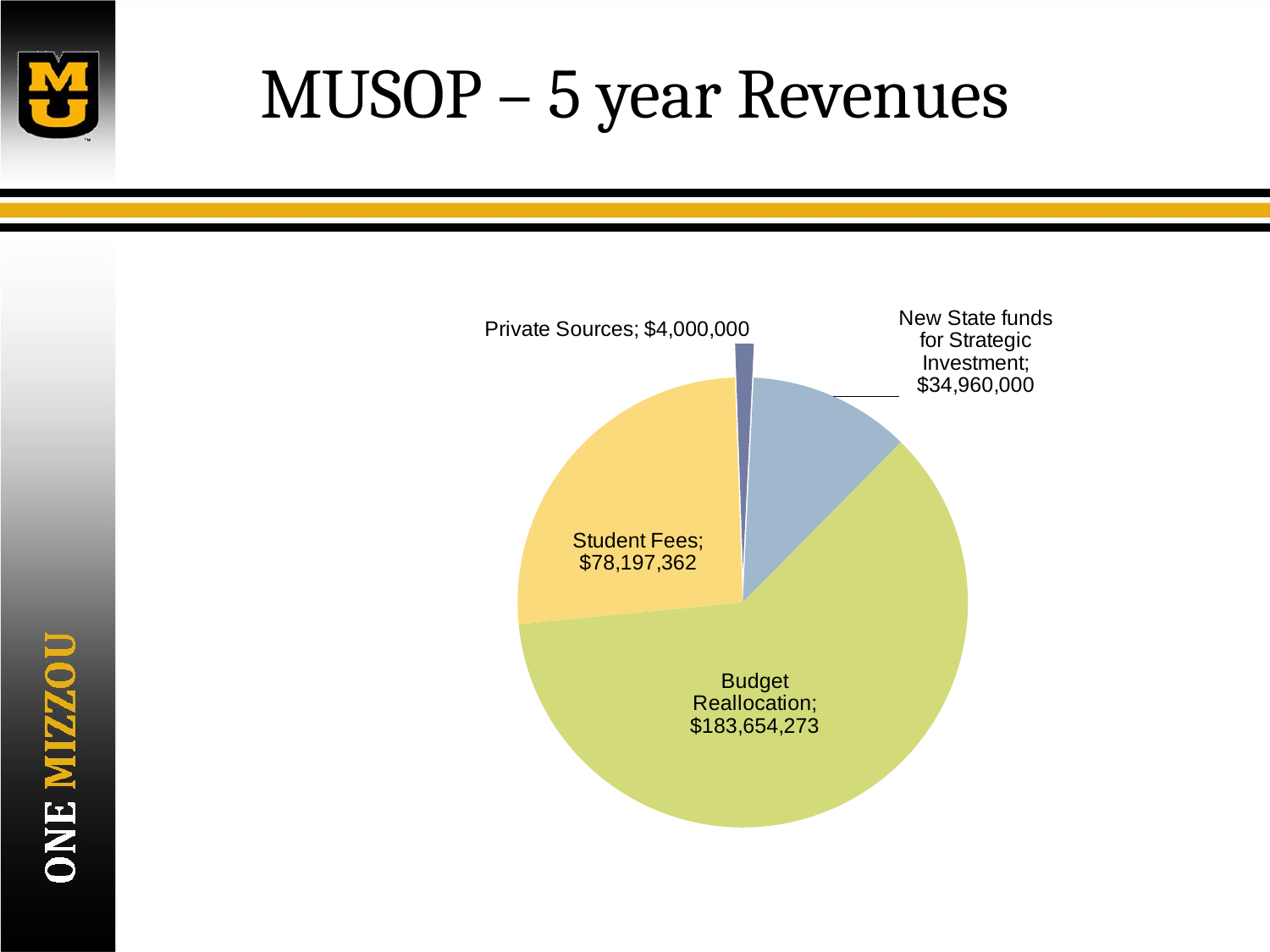
What is the title of the slide containing the pie chart? MUSOP – 5 year Revenues Which revenue source has the smallest slice of the pie? Private Sources What type of chart is shown on the slide? Pie chart Which revenue source has the largest slice of the pie? Budget Reallocation What is the difference between Budget Reallocation and Student Fees? $105,456,911 What is the value for New State funds for Strategic Investment? $34,960,000 What is the difference between New State funds for Strategic Investment and Private Sources? $30,960,000 What is the value for Student Fees? $78,197,362 Which is larger, Student Fees or New State funds for Strategic Investment? Student Fees What is the value for Private Sources? $4,000,000 What is the value for Budget Reallocation? $183,654,273 How many slices does the pie chart have? 4